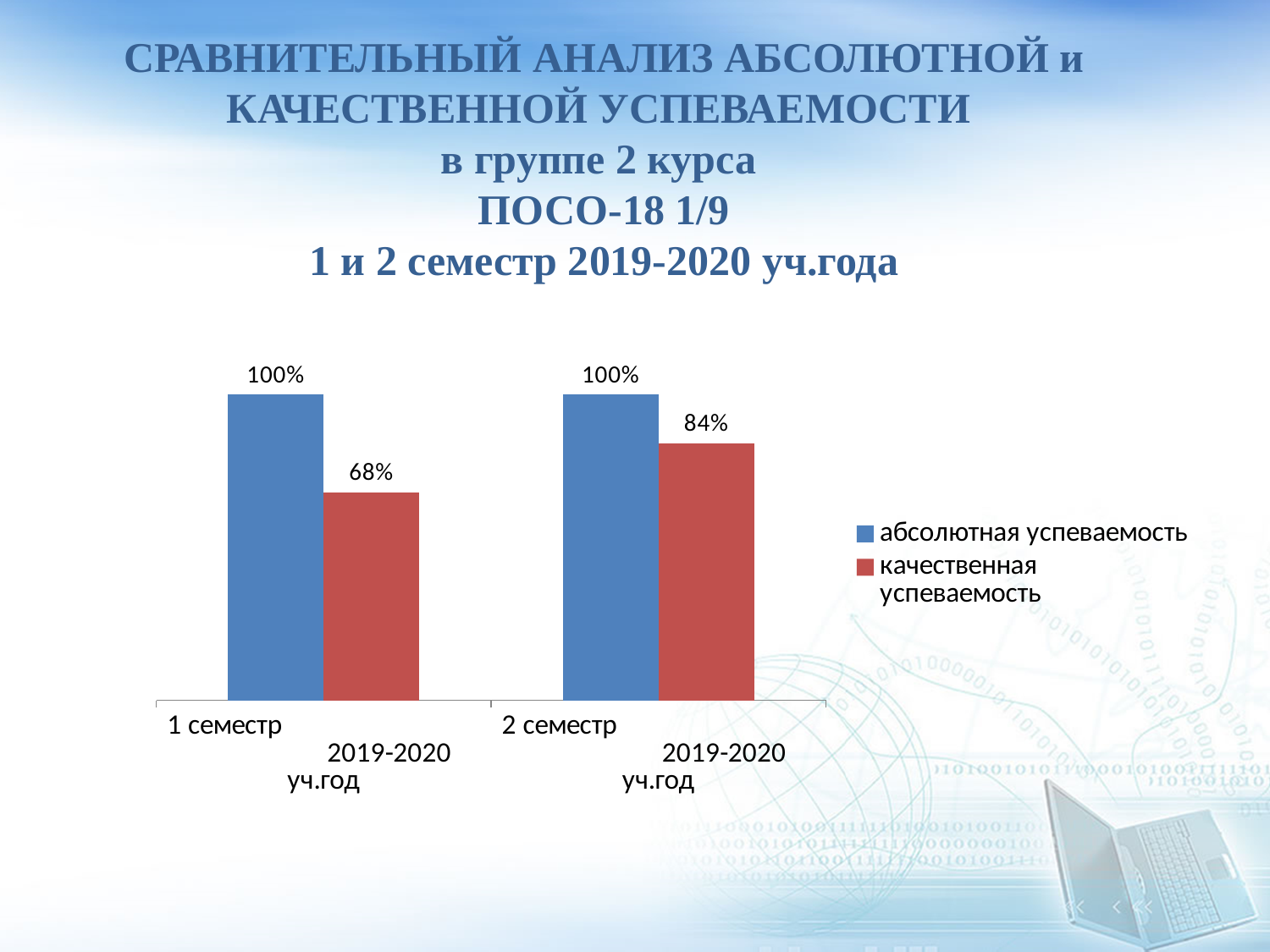
What is the difference between качественная успеваемость in 2 семестр and 1 семестр? 16% What kind of chart is shown on the slide? bar chart How many series does the legend list? 2 What is the difference between абсолютная успеваемость and качественная успеваемость in 1 семестр? 32% Which is larger in 2 семестр: абсолютная успеваемость or качественная успеваемость? абсолютная успеваемость What is the value of абсолютная успеваемость for 2 семестр 2019-2020 уч.год? 100% In which semester is качественная успеваемость lowest? 1 семестр 2019-2020 уч.год What is the value of качественная успеваемость for 1 семестр 2019-2020 уч.год? 68% What is the value of абсолютная успеваемость for 1 семестр 2019-2020 уч.год? 100% What is the value of качественная успеваемость for 2 семестр 2019-2020 уч.год? 84% Does качественная успеваемость rise or fall from 1 семестр to 2 семестр? rise In which semester is качественная успеваемость highest? 2 семестр 2019-2020 уч.год